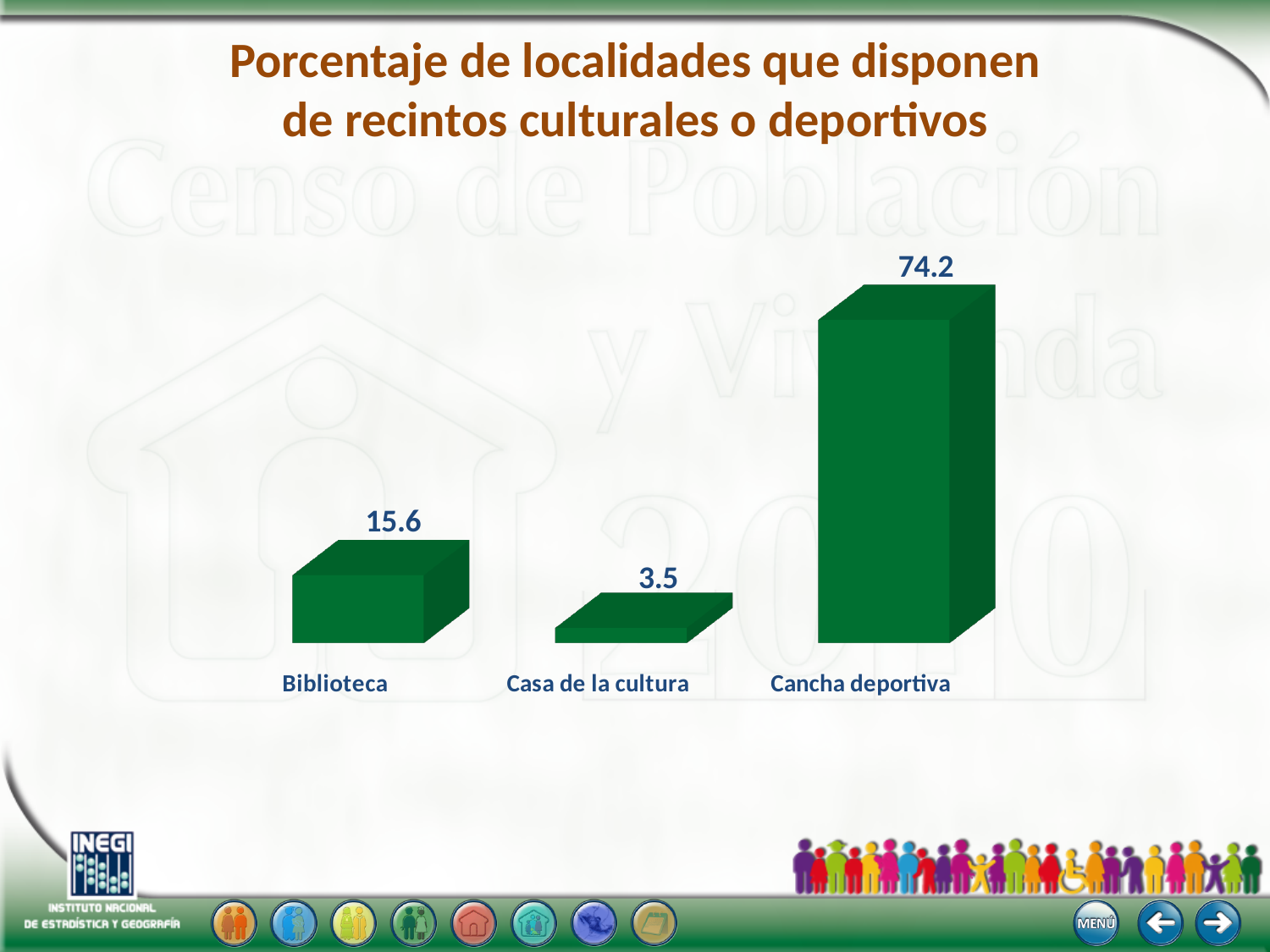
What is the difference between the values for Biblioteca and Casa de la cultura? 12.1 What colour are the bars in the chart? Green Which is larger, the value for Biblioteca or the value for Casa de la cultura? Biblioteca Which category has the lowest value? Casa de la cultura What is the title of the chart? Porcentaje de localidades que disponen de recintos culturales o deportivos What kind of chart is shown on the slide? Bar chart How many categories are shown in the chart? 3 What is the value for Cancha deportiva? 74.2 What is the value for Casa de la cultura? 3.5 What is the difference between the values for Cancha deportiva and Biblioteca? 58.6 Which category has the highest value? Cancha deportiva What is the value for Biblioteca? 15.6